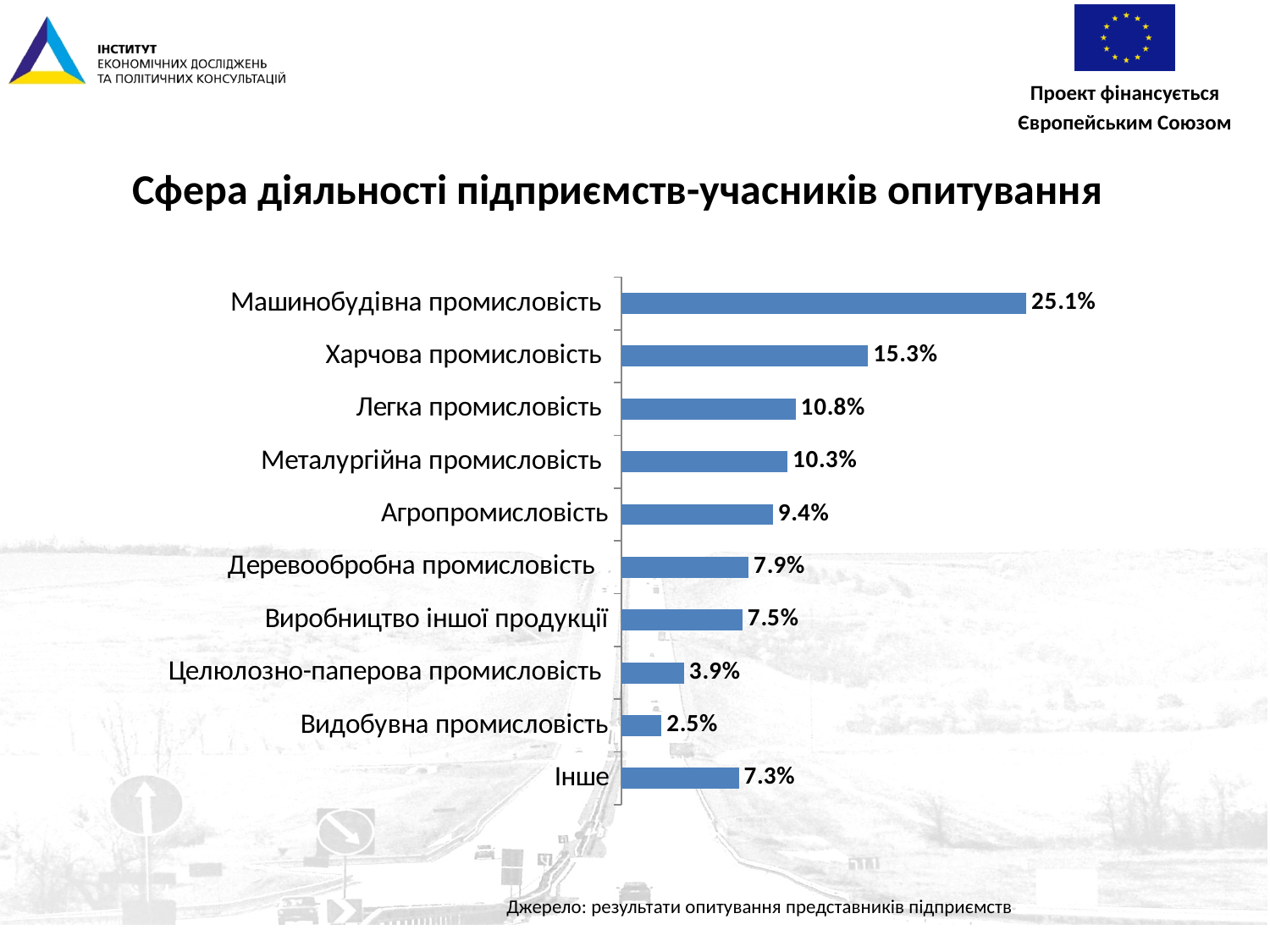
What is the title of the chart? Сфера діяльності підприємств-учасників опитування Which category has the highest value? Машинобудівна промисловість Which is larger, Агропромисловість or Деревообробна промисловість? Агропромисловість Which category has the lowest value? Видобувна промисловість What is the difference between Машинобудівна промисловість and Харчова промисловість? 9.8% What is the value for Машинобудівна промисловість? 25.1% What is the difference between Легка промисловість and Металургійна промисловість? 0.5% What is the value for Целюлозно-паперова промисловість? 3.9% How many categories are shown in the chart? 10 What is the value for Інше? 7.3% What kind of chart is shown on the slide? Bar chart What is the value for Харчова промисловість? 15.3%